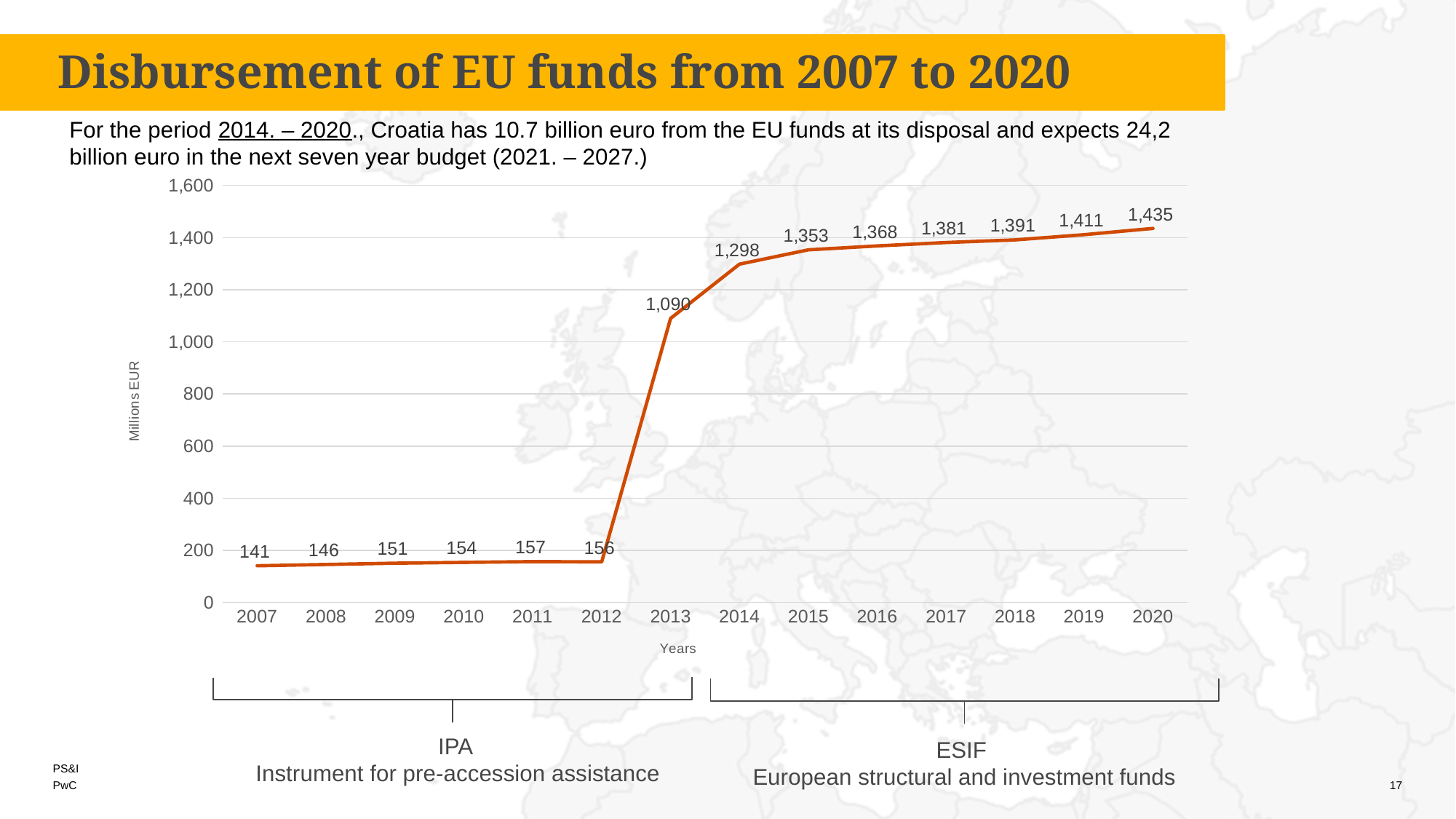
What is the difference between the values for 2014 and 2013? 208 Which is larger, the value for 2011 or the value for 2012? 2011 What is the value for 2007? 141 What is the value for 2012? 156 Which year has the highest value? 2020 Do the values generally rise or fall from 2007 to 2020? rise What is the label of the y axis? Millions EUR What is the value for 2020? 1,435 What is the value for 2013? 1,090 How many years are plotted on the x axis? 14 Which year has the lowest value? 2007 What kind of chart is shown on the slide? line chart